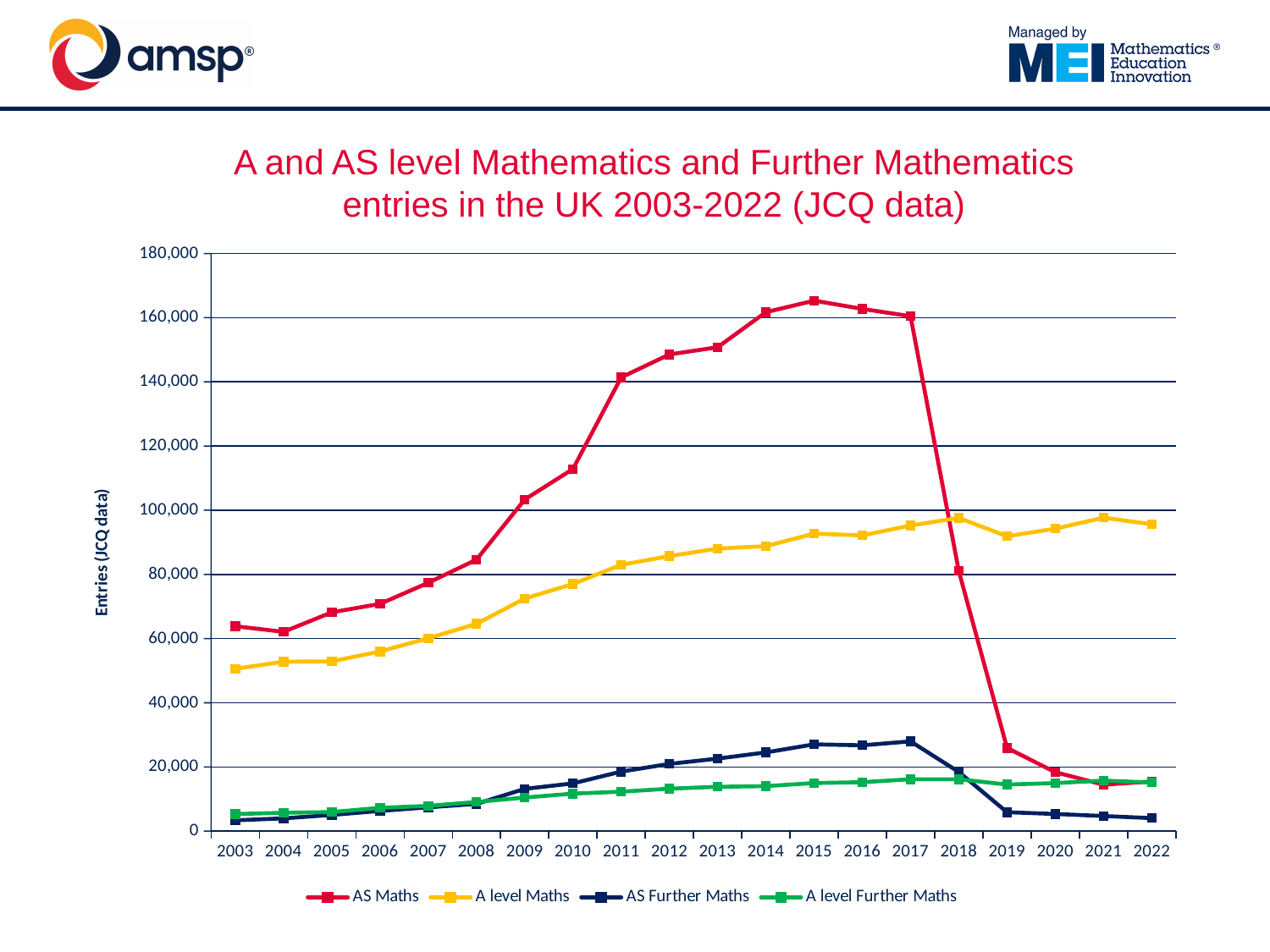
How many series does the legend list? 4 Do AS Maths entries rise or fall between 2017 and 2019? fall Is the value for A level Maths in 2003 greater or less than 60,000? less How many years are plotted along the x axis? 20 Which series has the lowest value in 2022? AS Further Maths In 2018, which is larger: AS Maths or A level Maths? A level Maths What kind of chart is shown on the slide? Line chart Which series has the highest value in 2010? AS Maths In 2022, which is larger: AS Further Maths or A level Further Maths? A level Further Maths Is the value for AS Maths in 2019 greater or less than 40,000? less Is the value for AS Maths in 2015 greater or less than 160,000? greater